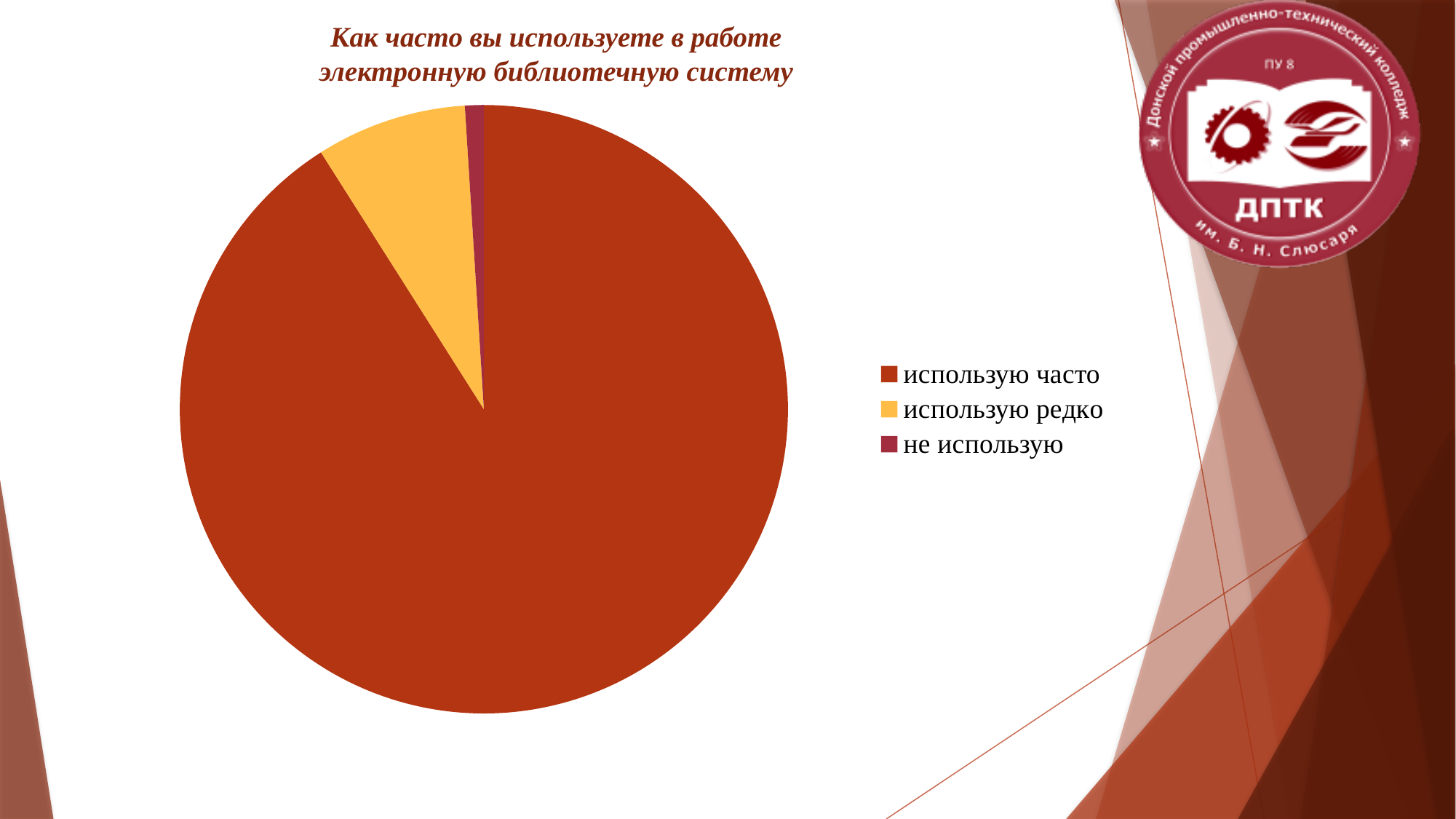
How many categories does the pie chart have? 3 What is the title of the chart? Как часто вы используете в работе электронную библиотечную систему What kind of chart is shown on the slide? pie chart Does the slice for использую часто take up more or less than half of the pie? more Which category is shown in yellow on the pie chart? использую редко Which slice is larger: использую часто or использую редко? использую часто Which slice is larger: использую редко or не использую? использую редко How many entries does the legend list? 3 Which category has the smallest slice of the pie? не использую Which category has the largest slice of the pie? использую часто